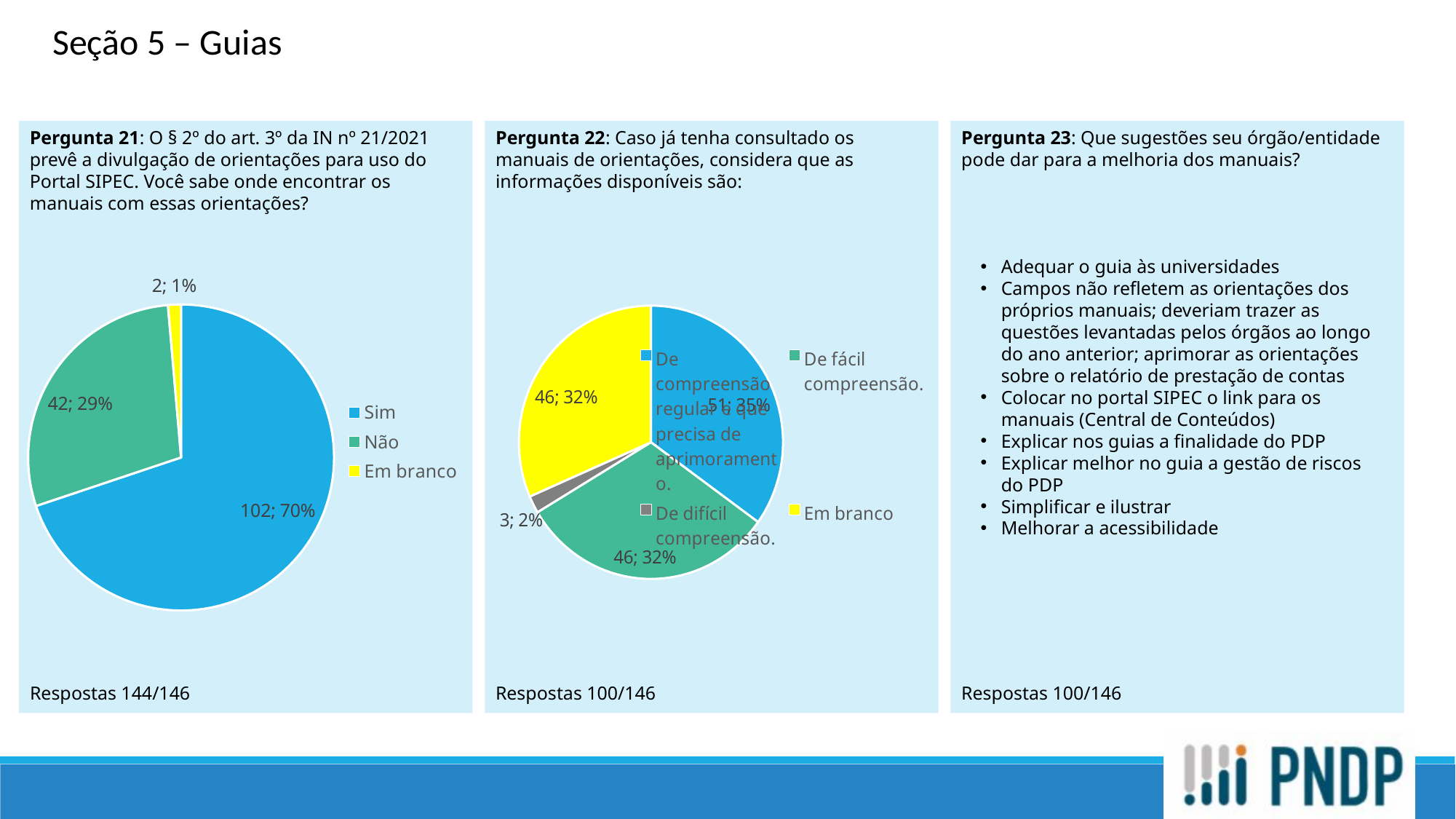
In the Pergunta 21 pie chart, how many responses were 'Sim'? 102 In the Pergunta 21 pie chart, what colour is the 'Em branco' slice? Yellow In the Pergunta 22 pie chart, which is larger: 'De fácil compreensão' or 'De difícil compreensão'? De fácil compreensão In the Pergunta 21 pie chart, what is the difference in number of responses between 'Sim' and 'Não'? 60 What type of chart is used for Pergunta 21? Pie chart In the Pergunta 21 pie chart, what percentage of responses were 'Não'? 29% In the Pergunta 21 pie chart, which category has the smallest slice? Em branco In the Pergunta 22 pie chart, what percentage of responses were 'Em branco'? 32% In the Pergunta 22 pie chart, which category has the largest slice? De compreensão regular e que precisa de aprimoramento. In the Pergunta 21 pie chart, how many categories does the legend list? 3 In the Pergunta 22 pie chart, how many categories does the legend list? 4 In the Pergunta 22 pie chart, how many responses were 'De difícil compreensão'? 3